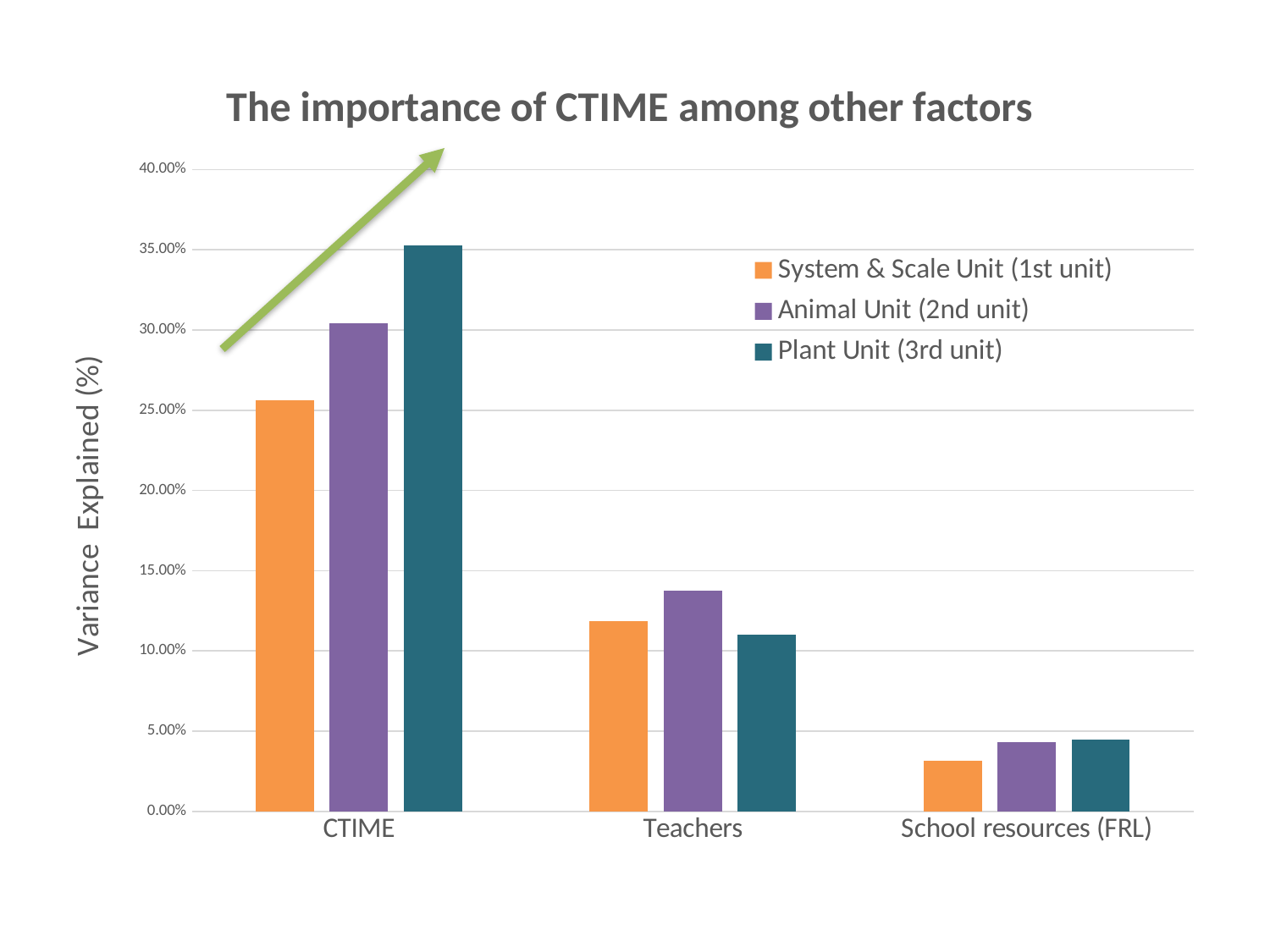
For CTIME, which is larger: the Plant Unit (3rd unit) value or the Animal Unit (2nd unit) value? Plant Unit (3rd unit) Which category has the highest value for the Plant Unit (3rd unit) series? CTIME Which category has the lowest value for the System & Scale Unit (1st unit) series? School resources (FRL) Is the value for Plant Unit (3rd unit) at CTIME greater or less than 30.00%? greater Is the value for System & Scale Unit (1st unit) at CTIME greater or less than 30.00%? less How many series does the legend list? 3 Do the Plant Unit (3rd unit) values rise or fall moving from CTIME to School resources (FRL) along the x axis? fall What kind of chart is shown on the slide? Bar chart For Teachers, which is larger: the Animal Unit (2nd unit) value or the Plant Unit (3rd unit) value? Animal Unit (2nd unit) How many categories are shown on the x axis? 3 What is the label on the vertical axis of the chart? Variance Explained (%) Is the value for Animal Unit (2nd unit) at Teachers greater or less than 15.00%? less